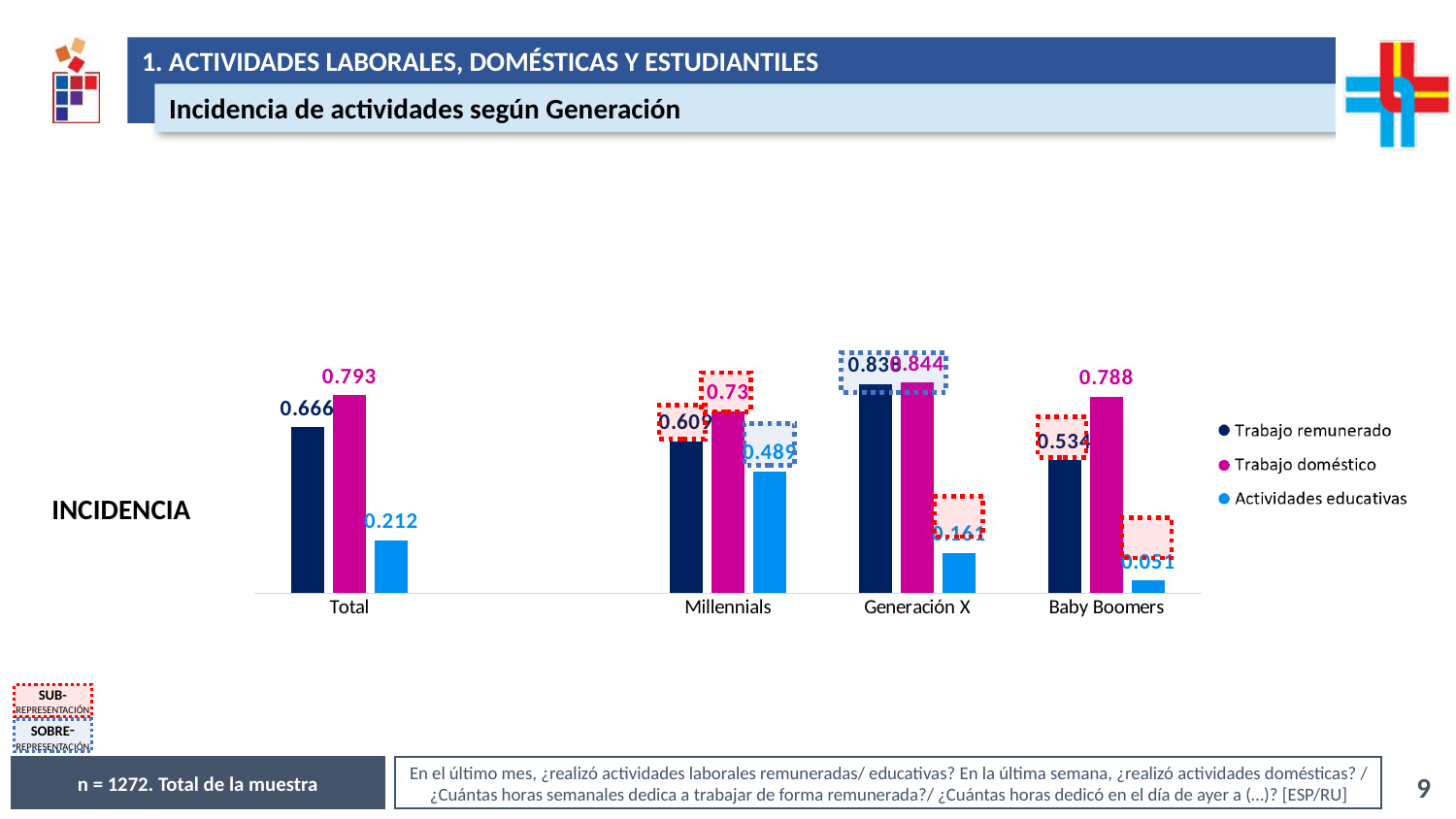
Which category has the highest value for Trabajo doméstico? Generación X For Total, what is the difference between Trabajo doméstico and Trabajo remunerado? 0.127 How many categories are shown on the x axis? 4 Which category has the lowest value for Actividades educativas? Baby Boomers What is the value of Trabajo doméstico for Millennials? 0.73 What is the value of Trabajo doméstico for Total? 0.793 What is the value of Trabajo remunerado for Total? 0.666 What kind of chart is shown on the slide? Bar chart What is the value of Actividades educativas for Total? 0.212 For Total, which is larger: Trabajo doméstico or Trabajo remunerado? Trabajo doméstico How many series does the legend list? 3 What is the value of Trabajo doméstico for Baby Boomers? 0.788